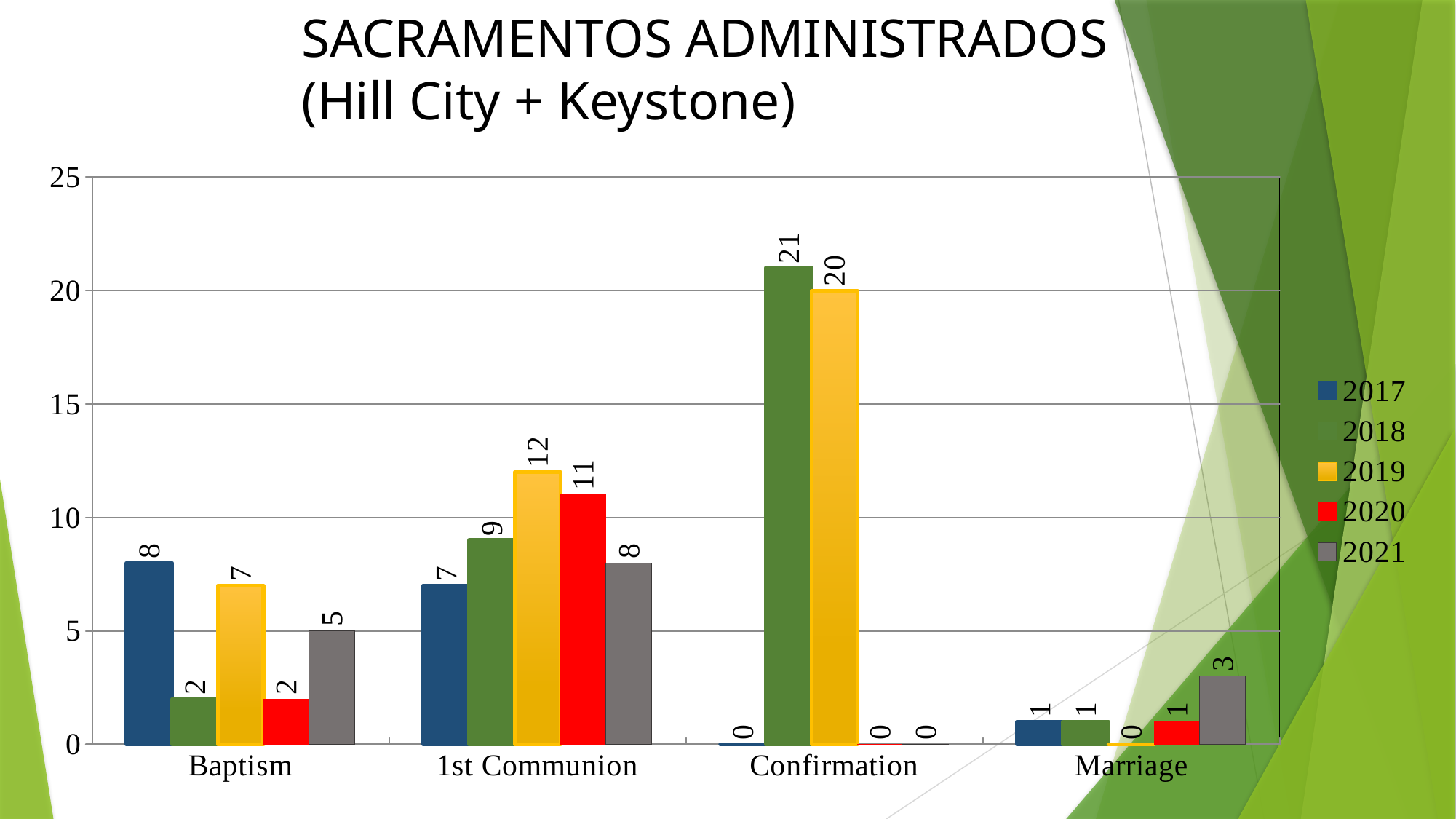
Which is larger: the 2017 value for Baptism or the 2017 value for 1st Communion? Baptism What is the value for 2020 in the 1st Communion category? 11 Which year has the lowest value in the Marriage category? 2019 How many series does the legend list? 5 What kind of chart is shown on the slide? bar chart What is the value for 2021 in the Marriage category? 3 Is the value for 2019 in the Confirmation category greater or less than 15? greater What is the value for 2018 in the Confirmation category? 21 How many categories are shown on the x axis? 4 What is the difference between the 2018 and 2019 values in the Confirmation category? 1 Which year has the highest value in the 1st Communion category? 2019 What is the value for 2019 in the Baptism category? 7